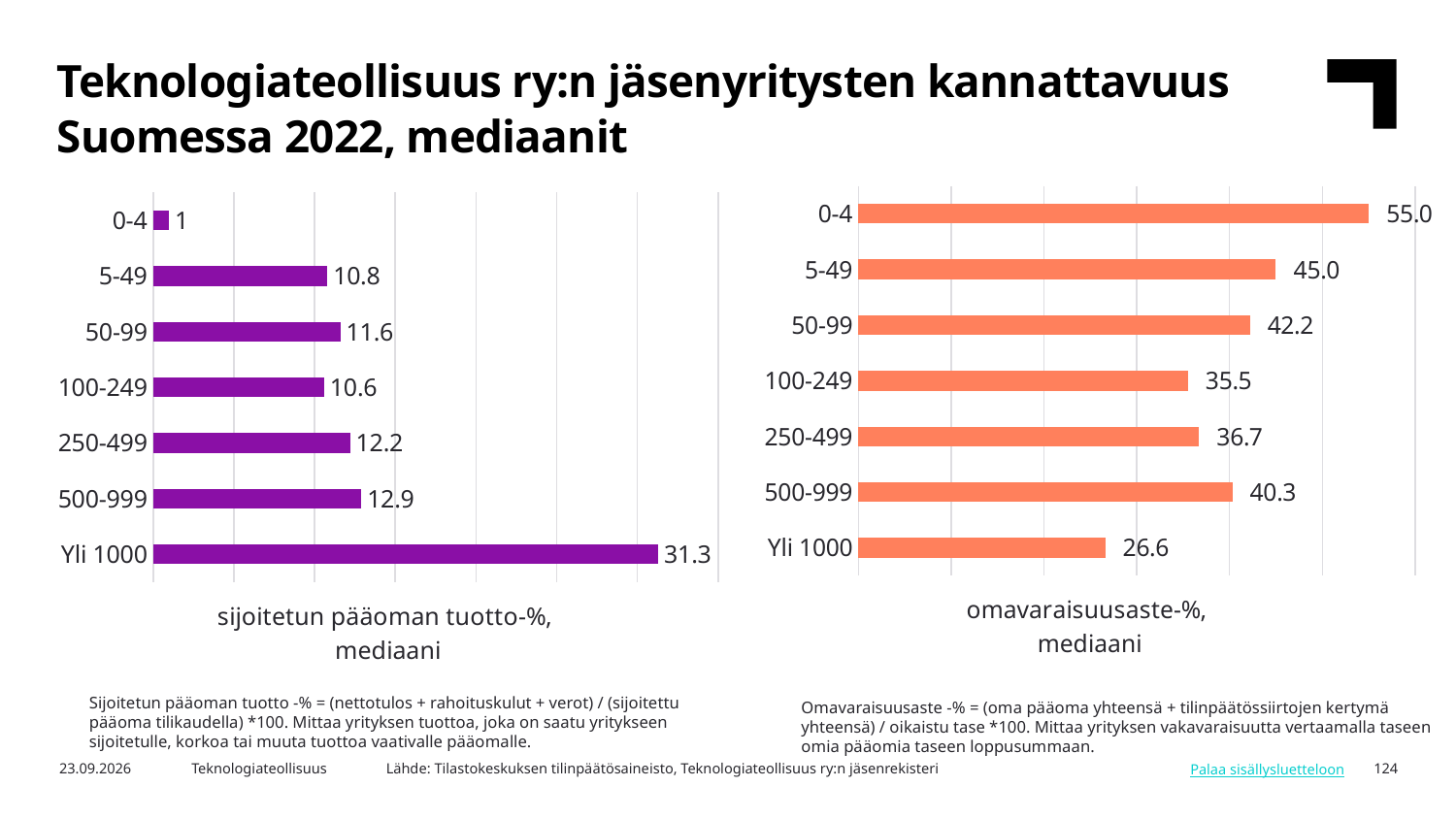
What kind of chart is the chart titled "sijoitetun pääoman tuotto-%, mediaani"? Bar chart In the chart titled "sijoitetun pääoman tuotto-%, mediaani", which is larger, the value for 50-99 or the value for 100-249? 50-99 In the chart titled "omavaraisuusaste-%, mediaani", which category has the lowest value? Yli 1000 In the chart titled "omavaraisuusaste-%, mediaani", which is larger, the value for 250-499 or the value for 500-999? 500-999 In the chart titled "sijoitetun pääoman tuotto-%, mediaani", what is the value for Yli 1000? 31.3 In the chart titled "sijoitetun pääoman tuotto-%, mediaani", which category has the lowest value? 0-4 In the chart titled "omavaraisuusaste-%, mediaani", which category has the highest value? 0-4 In the chart titled "sijoitetun pääoman tuotto-%, mediaani", what is the difference between the values for Yli 1000 and 500-999? 18.4 In the chart titled "omavaraisuusaste-%, mediaani", what is the value for 100-249? 35.5 In the chart titled "omavaraisuusaste-%, mediaani", what is the difference between the values for 0-4 and 5-49? 10.0 What colour are the bars in the chart titled "omavaraisuusaste-%, mediaani"? Orange How many categories does the chart titled "omavaraisuusaste-%, mediaani" show? 7